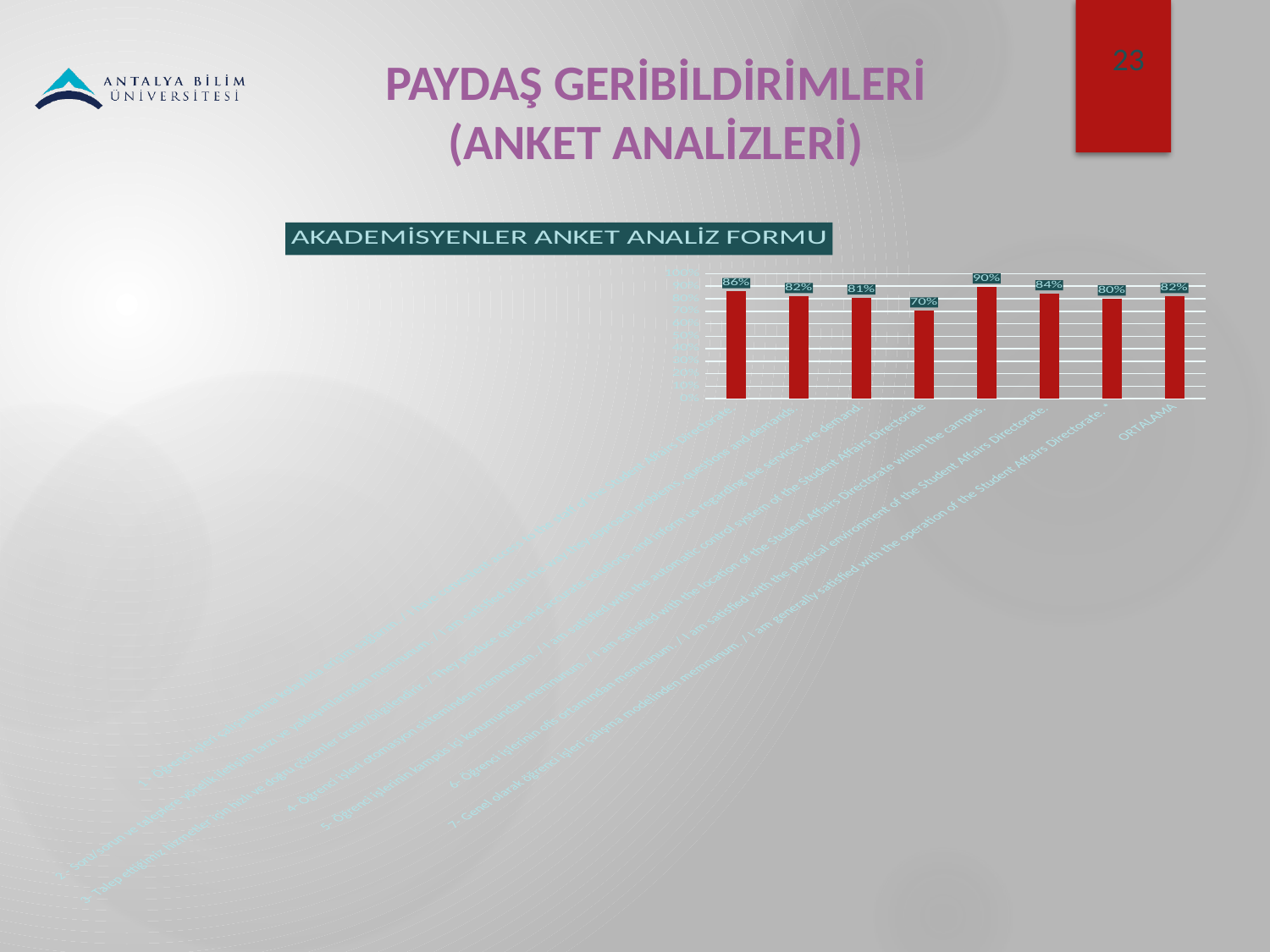
How many bars are plotted in the chart? 8 What is the difference between the first bar (86%) and the ORTALAMA bar (82%)? 4 percentage points What is the value of the fourth bar from the left? 70% What is the title shown above the chart? AKADEMİSYENLER ANKET ANALİZ FORMU What is the lowest value shown in the chart? 70% What is the highest value shown in the chart? 90% What is the value of the ORTALAMA bar? 82% What is the value of the first (leftmost) bar in the chart? 86% What colour are the bars in the chart? red What kind of chart is shown on the slide? bar chart Which is larger: the first bar (86%) or the ORTALAMA bar? the first bar (86%) What is the difference between the highest and lowest values in the chart? 20 percentage points